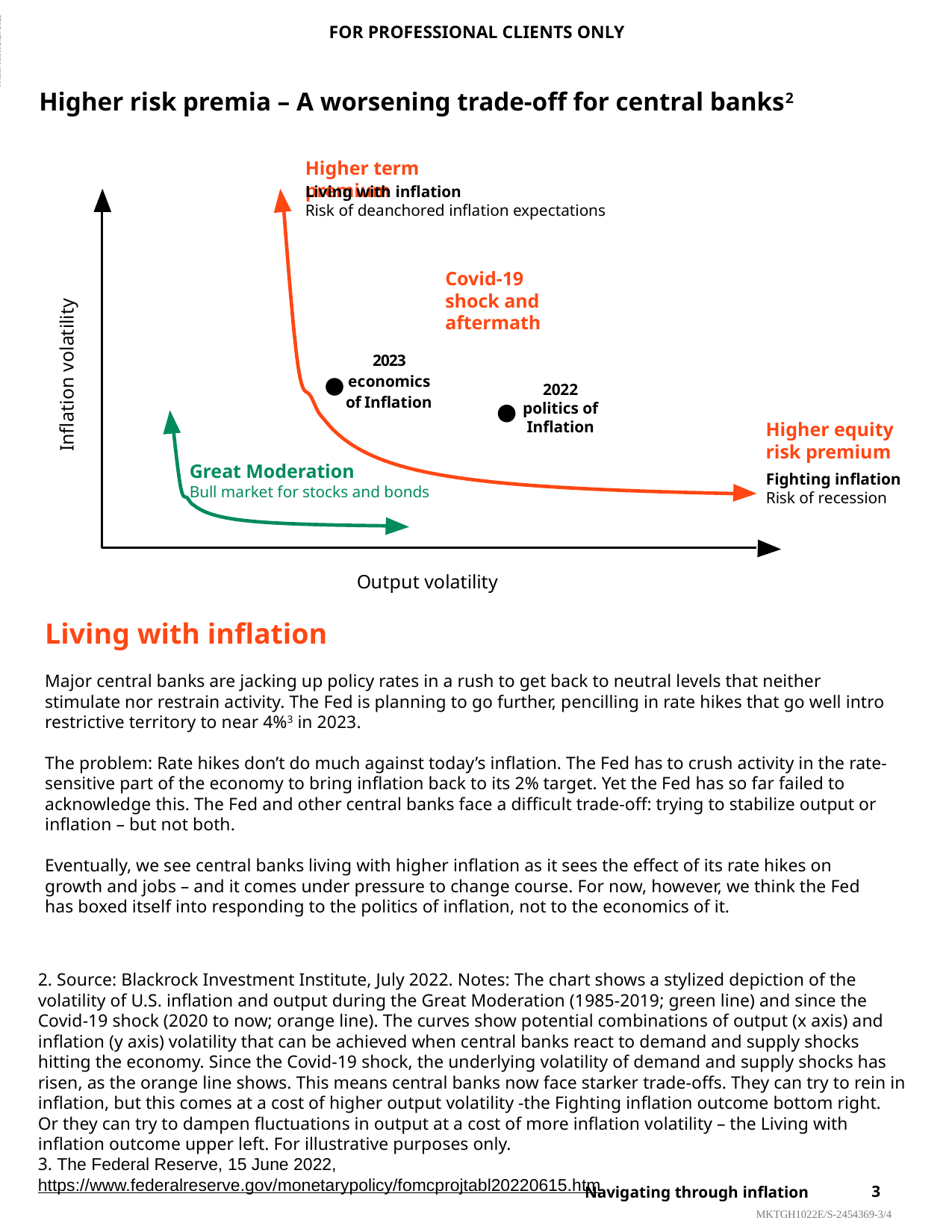
What kind of chart is shown on the slide? A line chart (stylized curves) Which plotted point has higher output volatility, '2023 economics of Inflation' or '2022 politics of Inflation'? 2022 politics of Inflation Which outcome is labelled at the lower-right end of the orange curve, 'Living with inflation' or 'Fighting inflation'? Fighting inflation Do the curves rise or fall as output volatility increases along the x axis? Fall Which curve lies higher on the chart, the Covid-19 shock and aftermath curve or the Great Moderation curve? Covid-19 shock and aftermath What is the label of the y axis of the chart? Inflation volatility How many curves are drawn on the chart? 2 How many labelled data points are plotted on the chart? 2 What is the label of the x axis of the chart? Output volatility